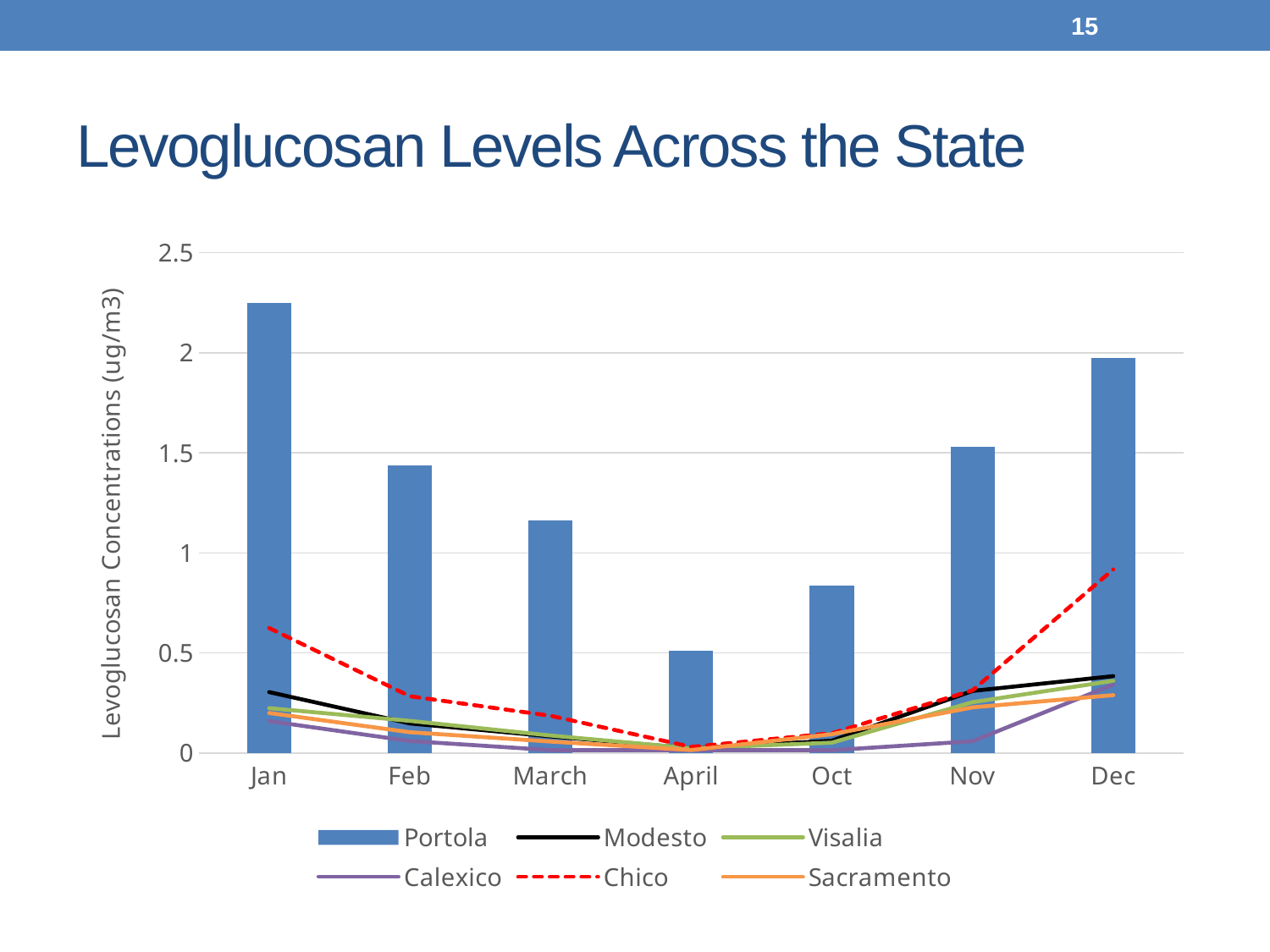
Is the Portola value for Oct greater or less than 1? less How many months are shown on the x axis? 7 In which month is the Portola bar lowest? April Is the Chico value for Dec greater or less than 1? less Which series is plotted as bars? Portola In which month is the Portola bar highest? Jan How many series does the legend list? 6 Is the Portola value for March greater or less than 1? greater Do the Portola bars rise or fall from Jan to April? Fall What kind of chart is shown on the slide? A combination bar and line chart Which is larger for Portola, the Jan value or the Dec value? Jan